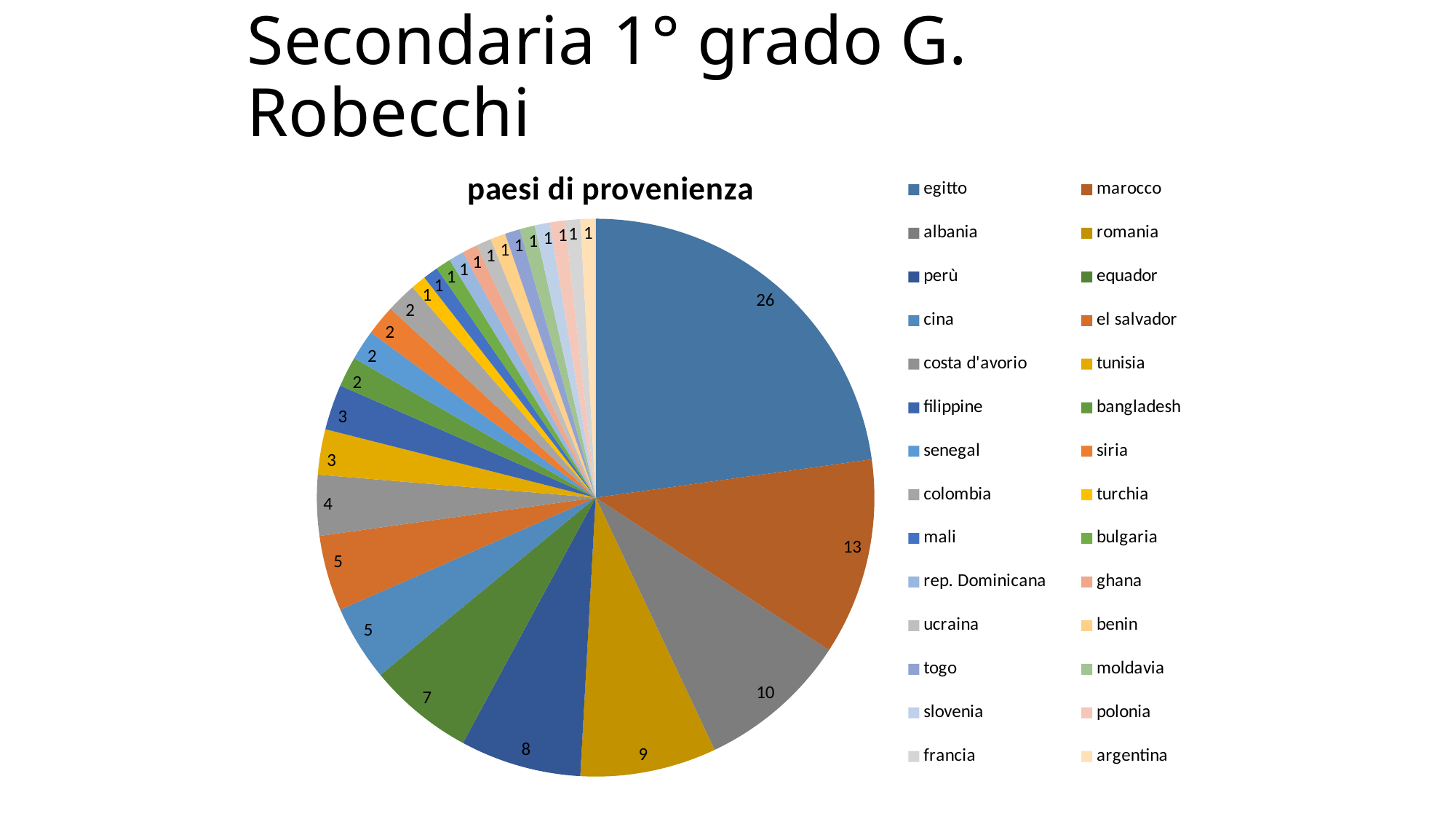
What is the difference between the values for egitto and marocco? 13 Which country has the largest slice in the pie chart? egitto What is the value for perù in the pie chart? 8 What is the value for costa d'avorio in the pie chart? 4 Which is larger, the value for albania or the value for romania? albania What is the value for marocco in the pie chart? 13 What is the value for equador in the pie chart? 7 What is the value for romania in the pie chart? 9 How many countries are listed in the legend of the pie chart? 28 What is the value for egitto in the pie chart? 26 What is the value for albania in the pie chart? 10 What kind of chart is shown on the slide? pie chart